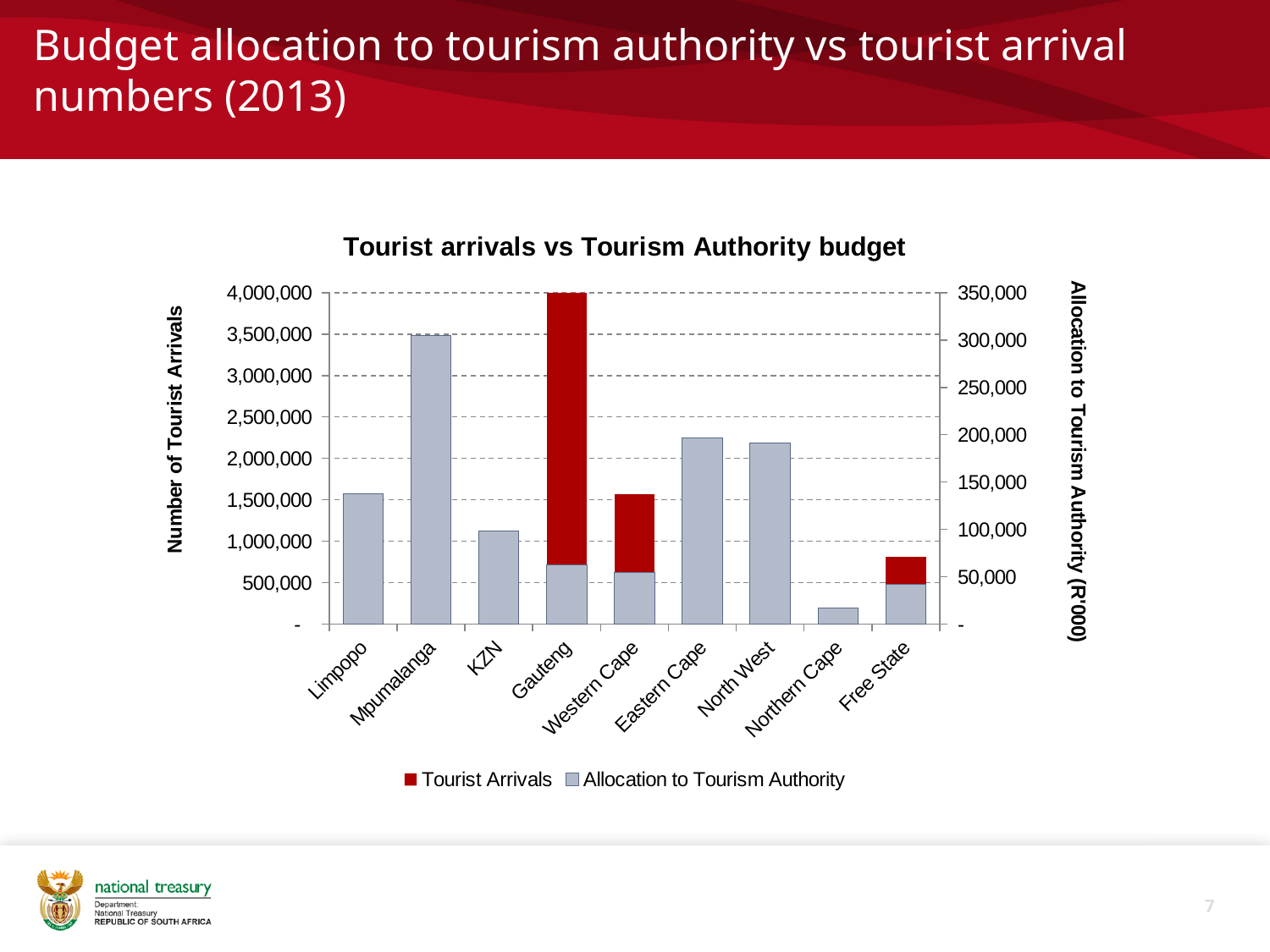
Which province has the highest Allocation to Tourism Authority? Mpumalanga How many series does the chart's legend list? 2 Is the Allocation to Tourism Authority for Mpumalanga greater or less than 250,000? greater How many provinces are shown on the x axis of the chart? 9 Which has the larger Allocation to Tourism Authority, Limpopo or KZN? Limpopo Is the Tourist Arrivals value for Free State greater or less than 1,000,000? less Is the Tourist Arrivals value for Gauteng greater or less than 3,500,000? greater Which province has the lowest Allocation to Tourism Authority? Northern Cape Which has the larger Tourist Arrivals value, Gauteng or Western Cape? Gauteng What is the title of the chart? Tourist arrivals vs Tourism Authority budget What kind of chart is shown on the slide? Bar chart